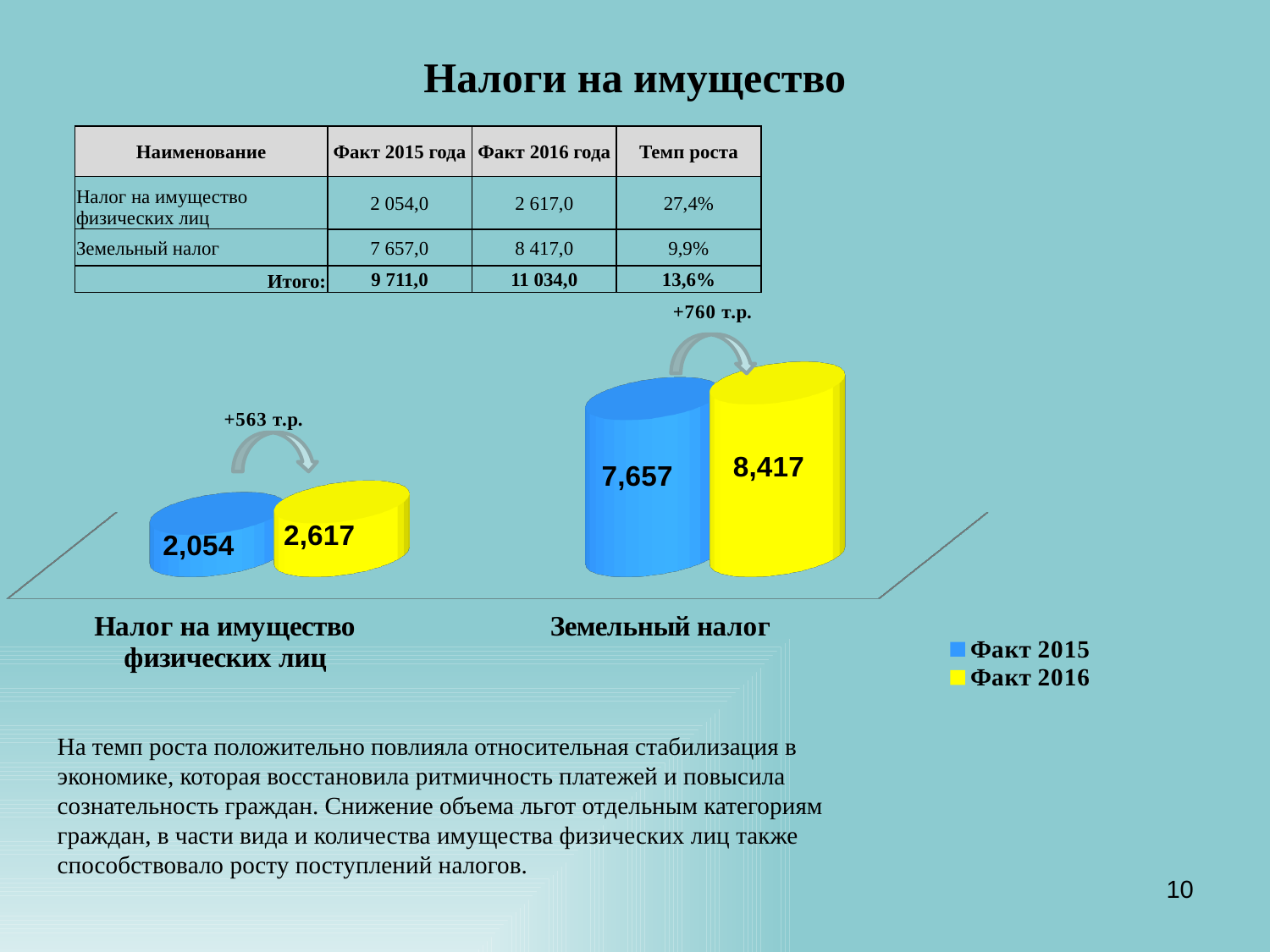
What is the difference between the Факт 2016 and Факт 2015 values for Налог на имущество физических лиц in the chart? 563 What is the value for Факт 2015 for Налог на имущество физических лиц in the chart? 2,054 What is the value for Факт 2016 for Налог на имущество физических лиц in the chart? 2,617 How many categories are shown on the x axis of the chart? 2 What is the value for Факт 2015 for Земельный налог in the chart? 7,657 What is the value for Факт 2016 for Земельный налог in the chart? 8,417 What type of chart is shown on the slide? Bar chart In the chart, which is larger for Земельный налог: the Факт 2015 value or the Факт 2016 value? Факт 2016 Which category has the highest Факт 2016 value in the chart? Земельный налог How many series does the chart legend list? 2 What is the difference between the Факт 2016 and Факт 2015 values for Земельный налог in the chart? 760 Which category has the lowest Факт 2015 value in the chart? Налог на имущество физических лиц